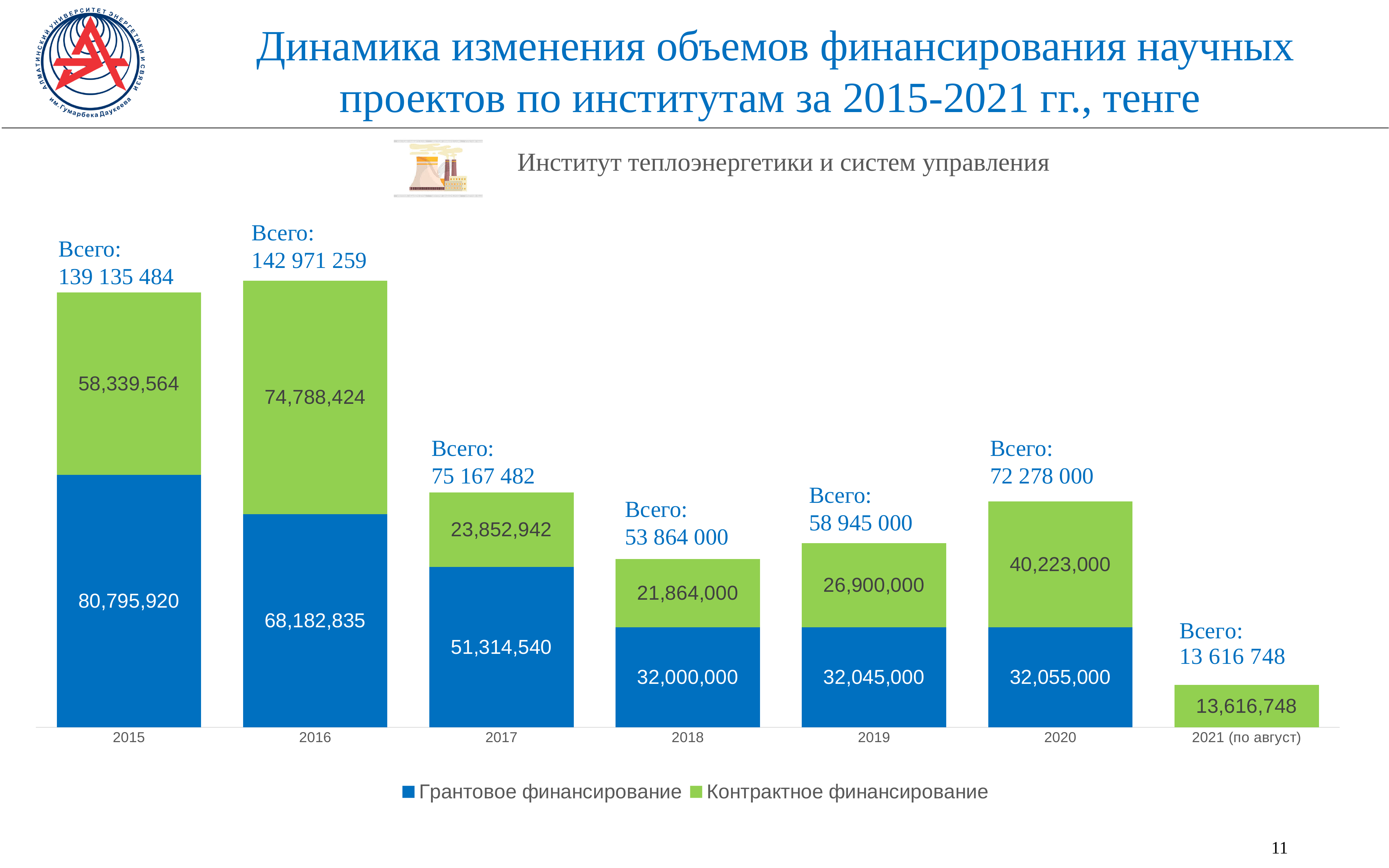
In 2016, which is larger: Грантовое финансирование or Контрактное финансирование? Контрактное финансирование What is the value of Грантовое финансирование for 2015? 80,795,920 What is the value of Контрактное финансирование for 2020? 40,223,000 Which year has the lowest total funding? 2021 (по август) What is the difference between Грантовое финансирование and Контрактное финансирование in 2015? 22,456,356 How many year categories are shown on the x axis? 7 How many series does the legend list? 2 Do the total funding values rise or fall from 2016 to 2018? Fall What type of chart is shown on the slide? Stacked bar chart Which year has the highest value of Грантовое финансирование? 2015 What is the total (Всего) for 2016? 142 971 259 Which year has the highest total funding? 2016